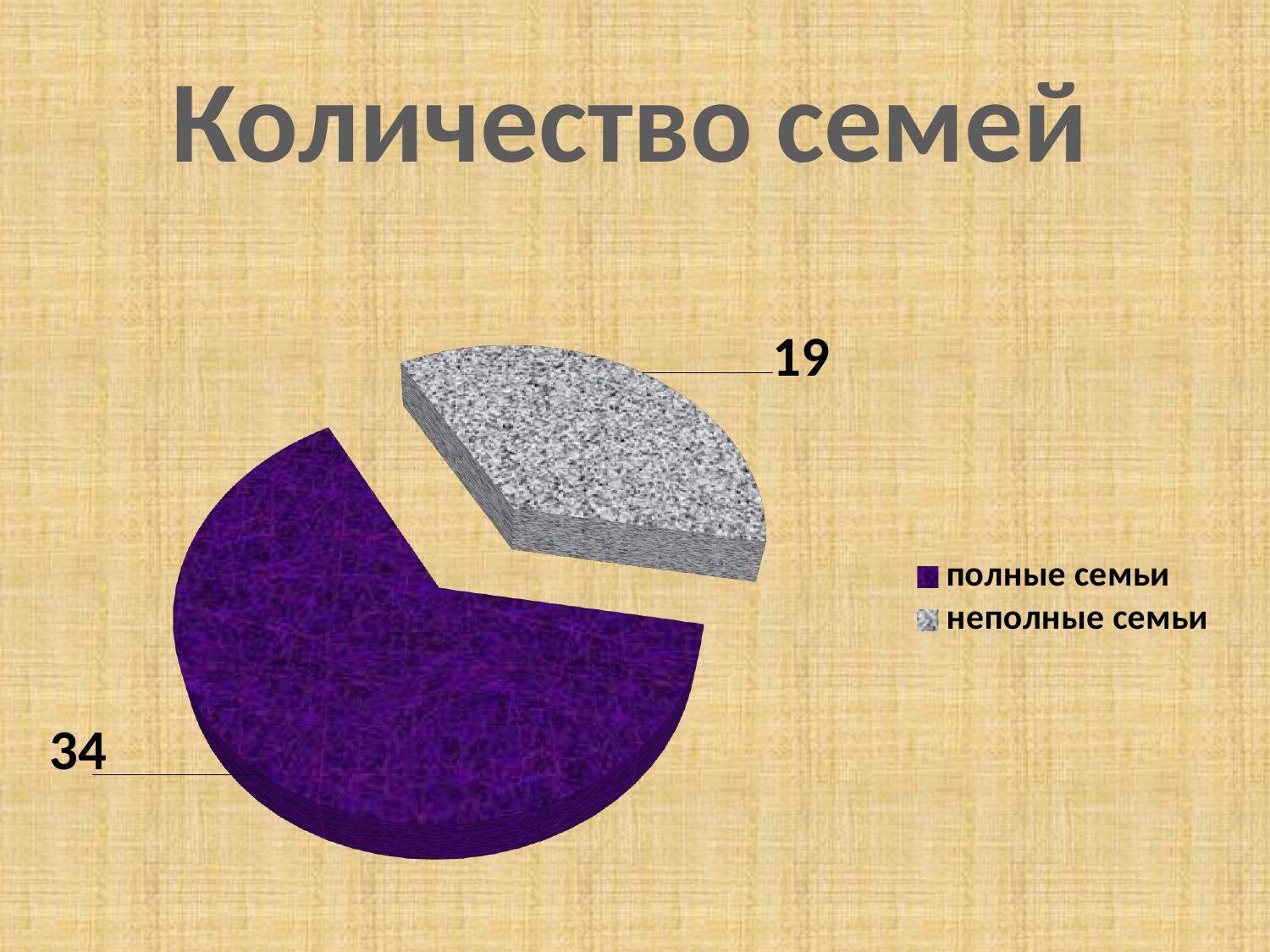
How many categories does the pie chart show? 2 What kind of chart is shown on the slide? pie chart Which category is shown in purple in the legend? полные семьи What is the value for полные семьи? 34 Which category has the largest slice of the pie? полные семьи Which is larger, the value for полные семьи or for неполные семьи? полные семьи What is the total of the two slices in the pie chart? 53 What is the title of the chart? Количество семей Which category has the smallest slice of the pie? неполные семьи What is the difference between the values for полные семьи and неполные семьи? 15 What is the value for неполные семьи? 19